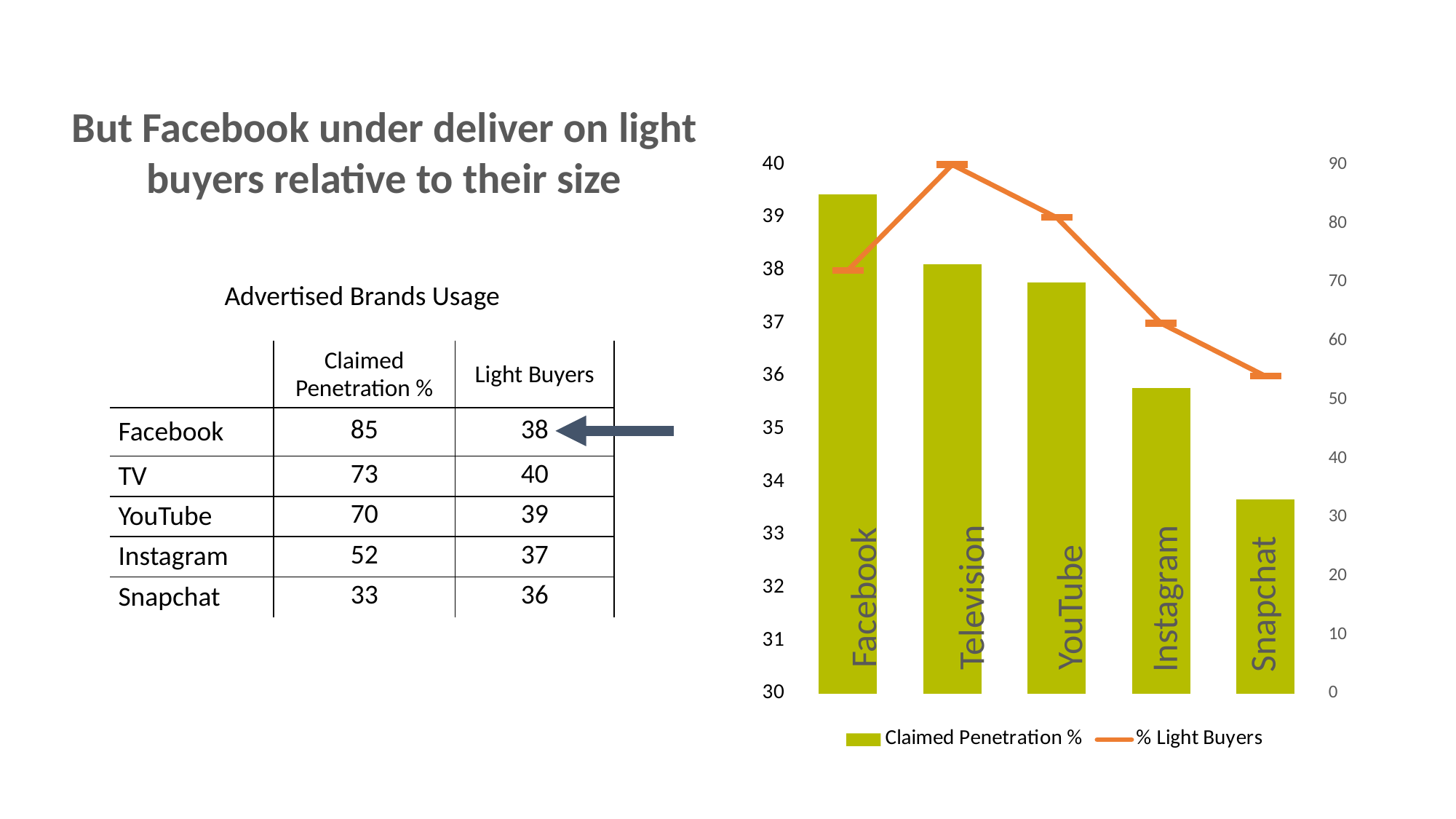
Which category has the lowest % Light Buyers value? Snapchat How many categories are plotted along the x axis of the chart? 5 How many series does the chart legend list? 2 What is the % Light Buyers value for Television? 40 What is the % Light Buyers value for Facebook? 38 Which category has the shortest Claimed Penetration % bar? Snapchat What is the difference between the % Light Buyers values for Television and Facebook? 2 What kind of chart is shown on the slide? A bar chart combined with a line chart Which category has the highest % Light Buyers value? Television Which category has the tallest Claimed Penetration % bar? Facebook Do the Claimed Penetration % bars rise or fall from left to right across the x axis? Fall Is the Claimed Penetration % value for YouTube greater or less than 60? greater